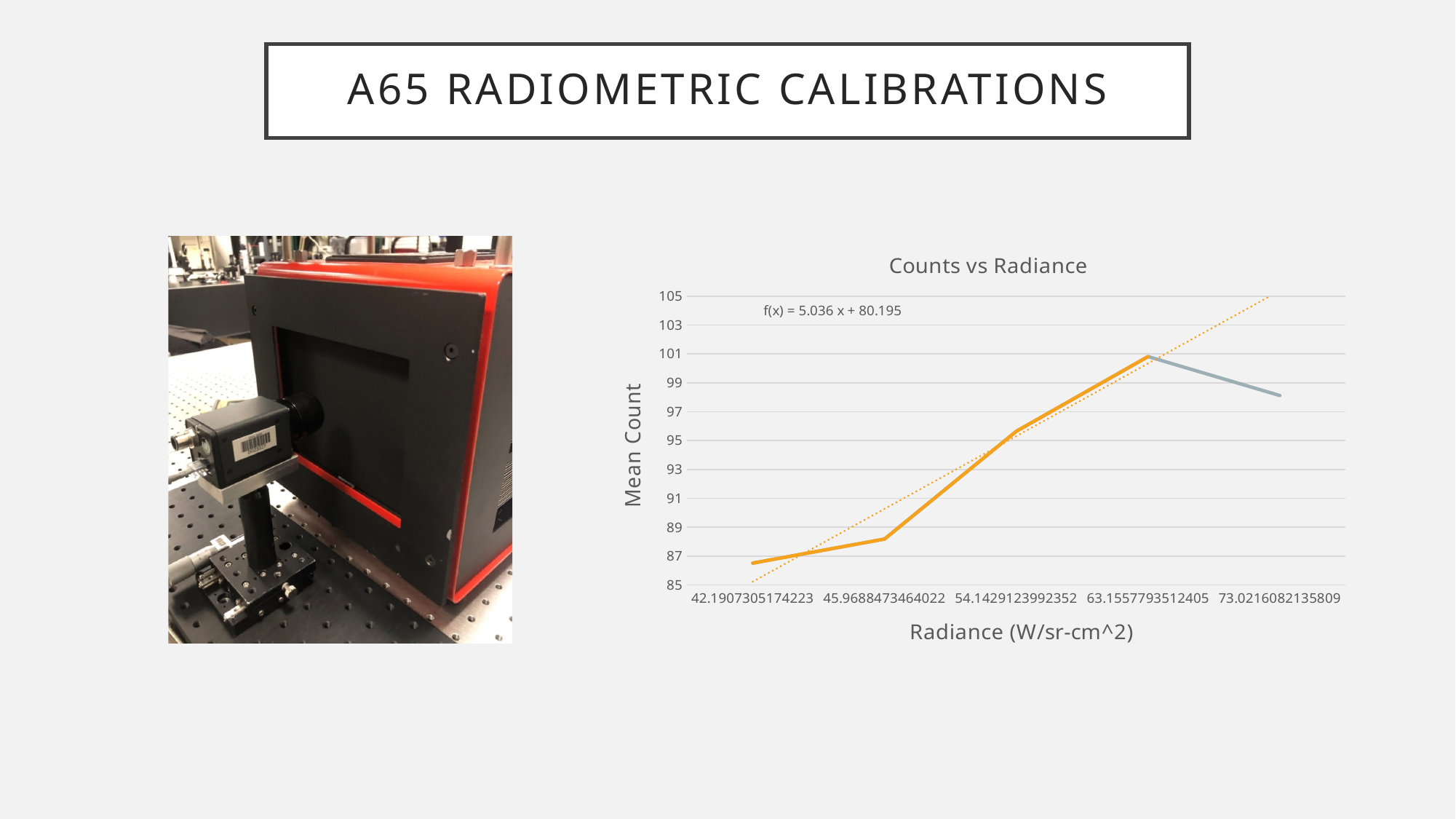
What is the title of the chart? Counts vs Radiance Is the mean count at radiance 73.0216082135809 greater or less than 99? less Which has the larger mean count: radiance 63.1557793512405 or radiance 73.0216082135809? 63.1557793512405 Is the mean count at radiance 54.1429123992352 greater or less than 93? greater Is the mean count at radiance 63.1557793512405 greater or less than 99? greater At which radiance value is the mean count highest? 63.1557793512405 What is the trendline equation printed on the chart? f(x) = 5.036 x + 80.195 How many radiance values are labelled along the x axis? 5 What kind of chart is shown on the slide? line chart At which radiance value is the mean count lowest? 42.1907305174223